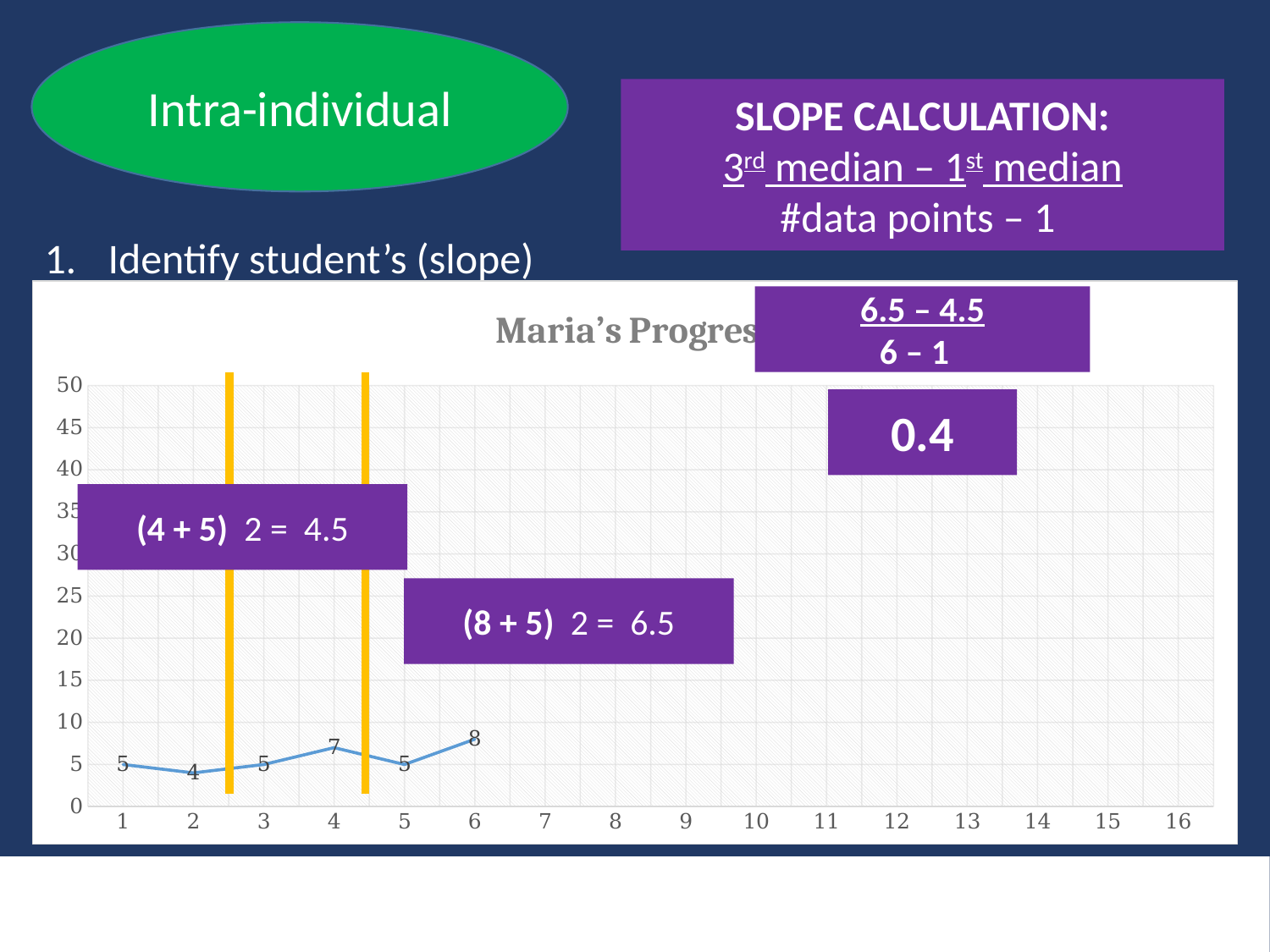
At which x value does the line reach its lowest point? 2 How many data points are plotted on the line? 6 What is the difference between the value at x = 6 and the value at x = 2? 4 What is the value plotted at x = 1 on the Maria's Progress chart? 5 What kind of chart is shown on the slide? line chart Which is larger, the value at x = 4 or the value at x = 5? x = 4 What is the value plotted at x = 6 on the Maria's Progress chart? 8 What is the title of the chart? Maria's Progress Is the value at x = 6 greater or less than 10? less What is the value plotted at x = 4 on the Maria's Progress chart? 7 At which x value does the line reach its highest point? 6 What is the value plotted at x = 2 on the Maria's Progress chart? 4